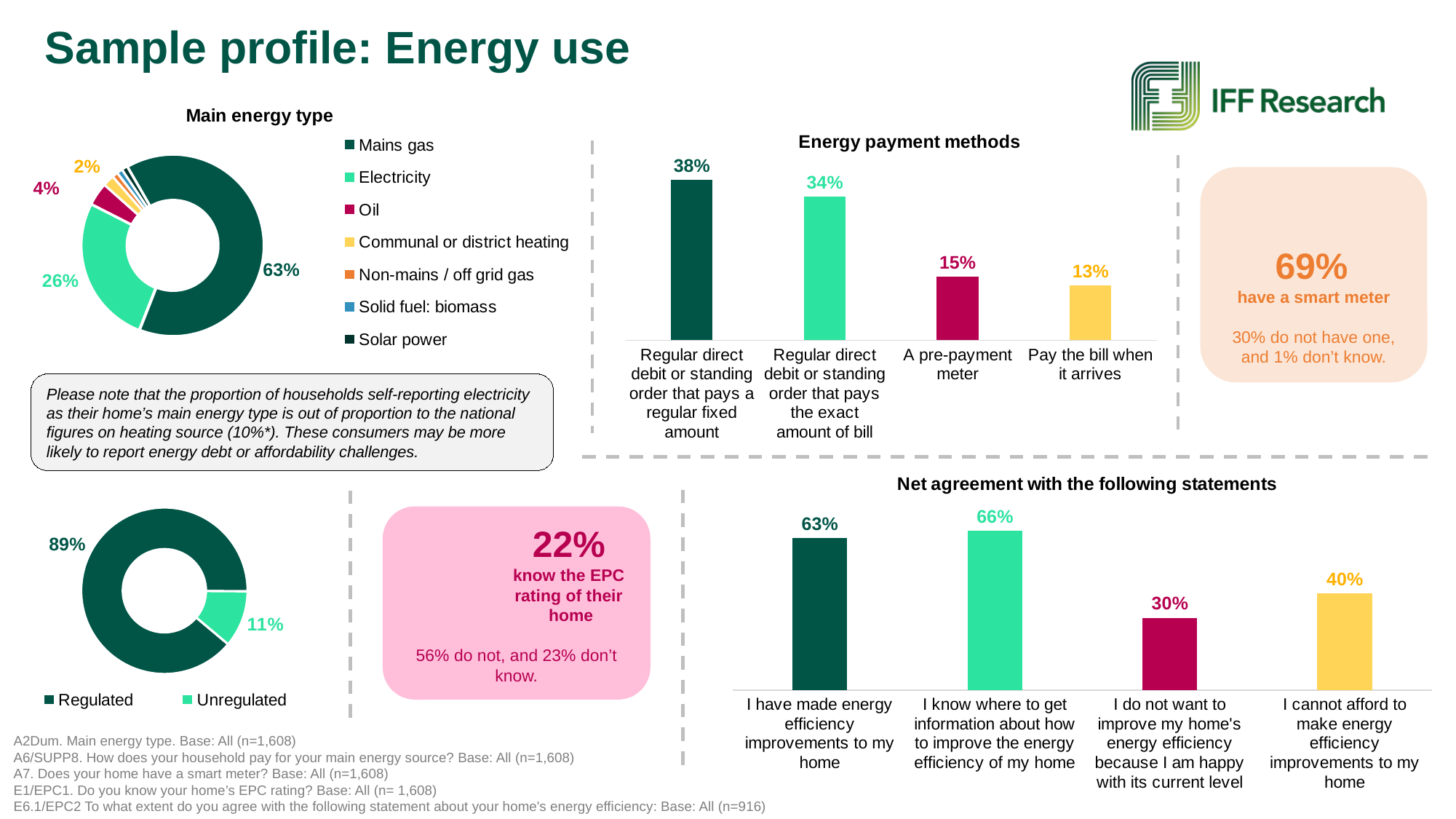
In the 'Net agreement with the following statements' chart, which is larger: 'I have made energy efficiency improvements to my home' or 'I do not want to improve my home's energy efficiency because I am happy with its current level'? I have made energy efficiency improvements to my home In the 'Net agreement with the following statements' chart, what is the value for 'I cannot afford to make energy efficiency improvements to my home'? 40% How many entries does the legend of the 'Main energy type' chart list? 7 How many categories are shown in the 'Energy payment methods' chart? 4 In the 'Main energy type' chart, what percentage is shown for electricity? 26% In the 'Main energy type' chart, what share of households report mains gas as their main energy type? 63% In the 'Energy payment methods' chart, which payment method has the highest value? Regular direct debit or standing order that pays a regular fixed amount In the 'Energy payment methods' chart, what is the value for 'A pre-payment meter'? 15% In the Regulated/Unregulated donut chart at the bottom left, what percentage is Unregulated? 11% In the 'Energy payment methods' chart, what is the difference between the two regular direct debit options (38% and 34%)? 4 percentage points What kind of chart is the 'Main energy type' chart? Donut (pie) chart In the 'Net agreement with the following statements' chart, which statement has the highest net agreement? I know where to get information about how to improve the energy efficiency of my home